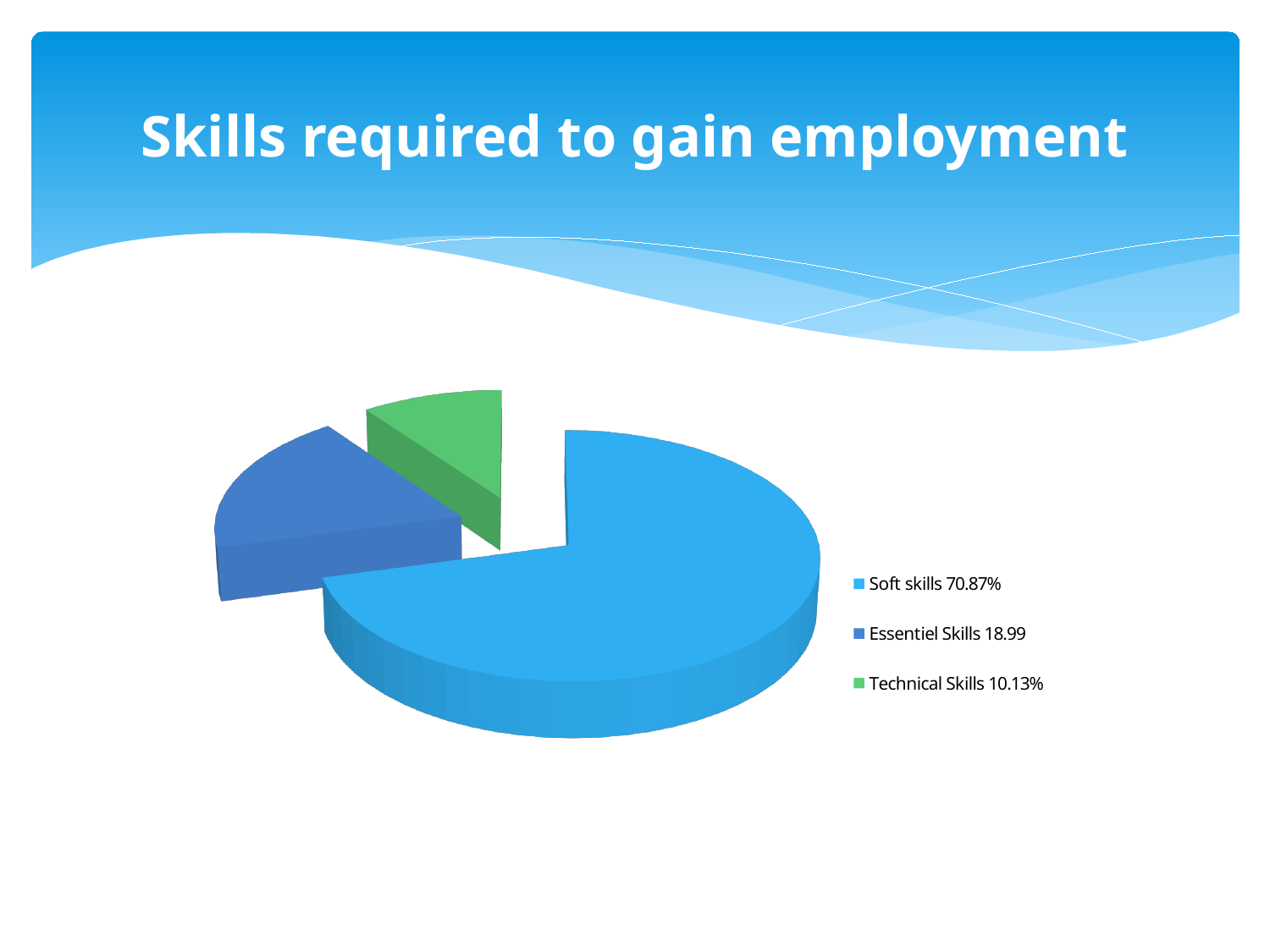
Which category has the largest slice of the pie? Soft skills What is the title of the slide containing the pie chart? Skills required to gain employment What percentage is shown for Soft skills in the legend? 70.87% What percentage is shown for Technical Skills in the legend? 10.13% Which is larger, the slice for Essentiel Skills or the slice for Technical Skills? Essentiel Skills What share of the pie does Soft skills represent? 70.87% What value is shown for Essentiel Skills in the legend? 18.99 Which category has the smallest slice of the pie? Technical Skills What kind of chart is shown on the slide? Pie chart What is the difference between the Soft skills share and the Technical Skills share? 60.74% What colour is the Technical Skills slice? Green How many slices does the pie chart have? 3